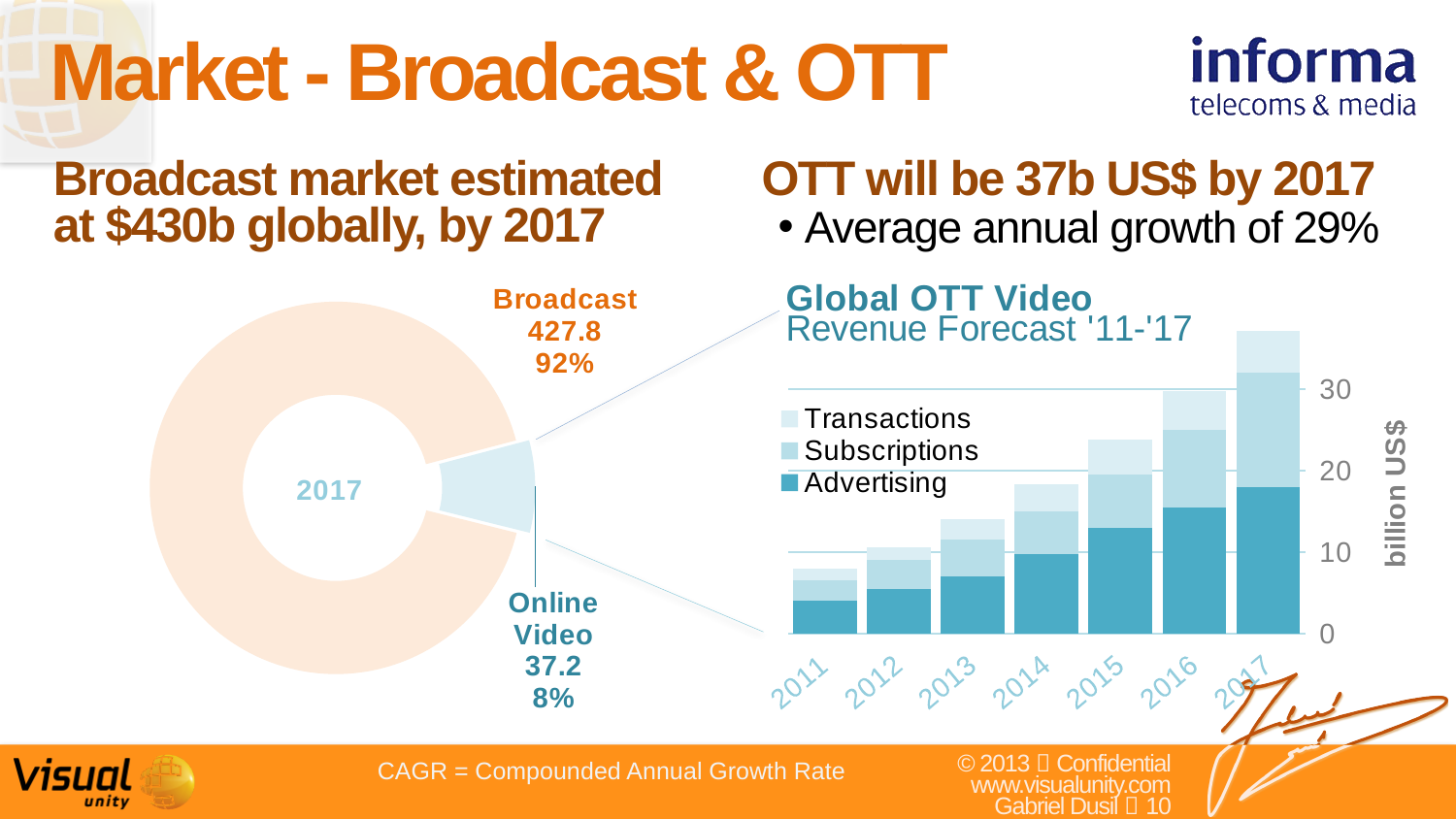
In the Global OTT Video Revenue Forecast chart, is the total for 2011 greater or less than 10? less In the Global OTT Video Revenue Forecast chart, is the total for 2017 greater or less than 30? greater In the pie chart on the left, what is the difference between the Broadcast value and the Online Video value? 390.6 In the pie chart on the left, what year is labelled in the centre of the chart? 2017 In the pie chart on the left, which slice is larger, Broadcast or Online Video? Broadcast In the pie chart on the left, what value is shown for Broadcast? 427.8 What kind of chart is the Global OTT Video Revenue Forecast chart? Stacked bar chart How many years are shown on the x axis of the Global OTT Video Revenue Forecast chart? 7 What kind of chart is the chart on the left of the slide? Pie chart (donut) In the Global OTT Video Revenue Forecast chart, do the total bar heights rise or fall from 2011 to 2017? Rise How many series does the legend of the Global OTT Video Revenue Forecast chart list? 3 In the pie chart on the left, what share does Online Video have? 8%